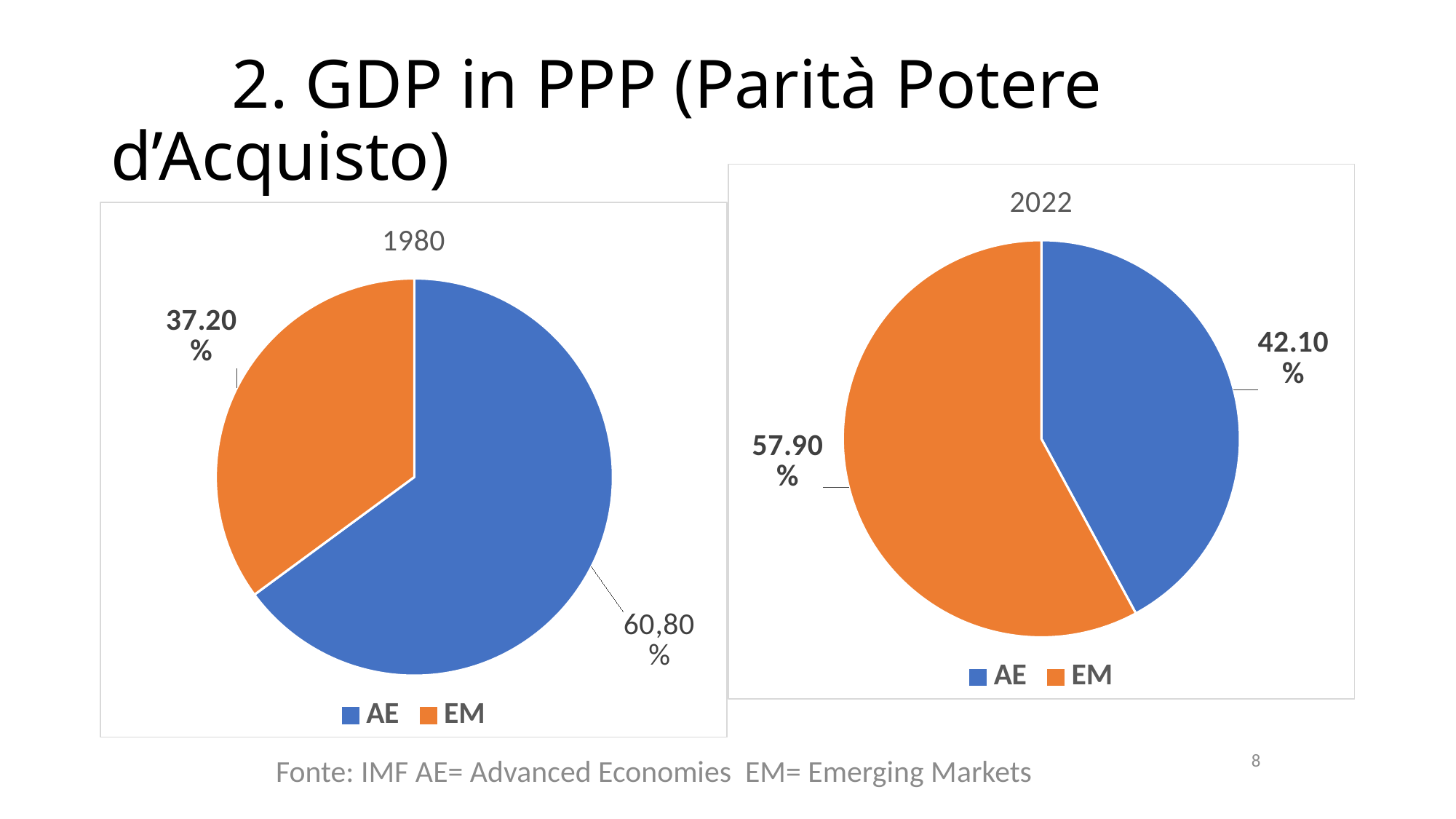
How many slices does the 2022 chart have? 2 How many entries does the legend of the 1980 chart list? 2 What is the title of the chart on the right? 2022 In the 2022 chart, what colour is the EM slice? orange What kind of chart is the 1980 chart? pie chart In the 2022 chart, what share does EM have? 57.90% In the 2022 chart, what share does AE have? 42.10% In the 2022 chart, which slice is the smallest? AE In the 1980 chart, what share does AE have? 60,80% In the 2022 chart, which is larger, AE or EM? EM In the 1980 chart, what share does EM have? 37.20% In the 1980 chart, which slice is the largest? AE